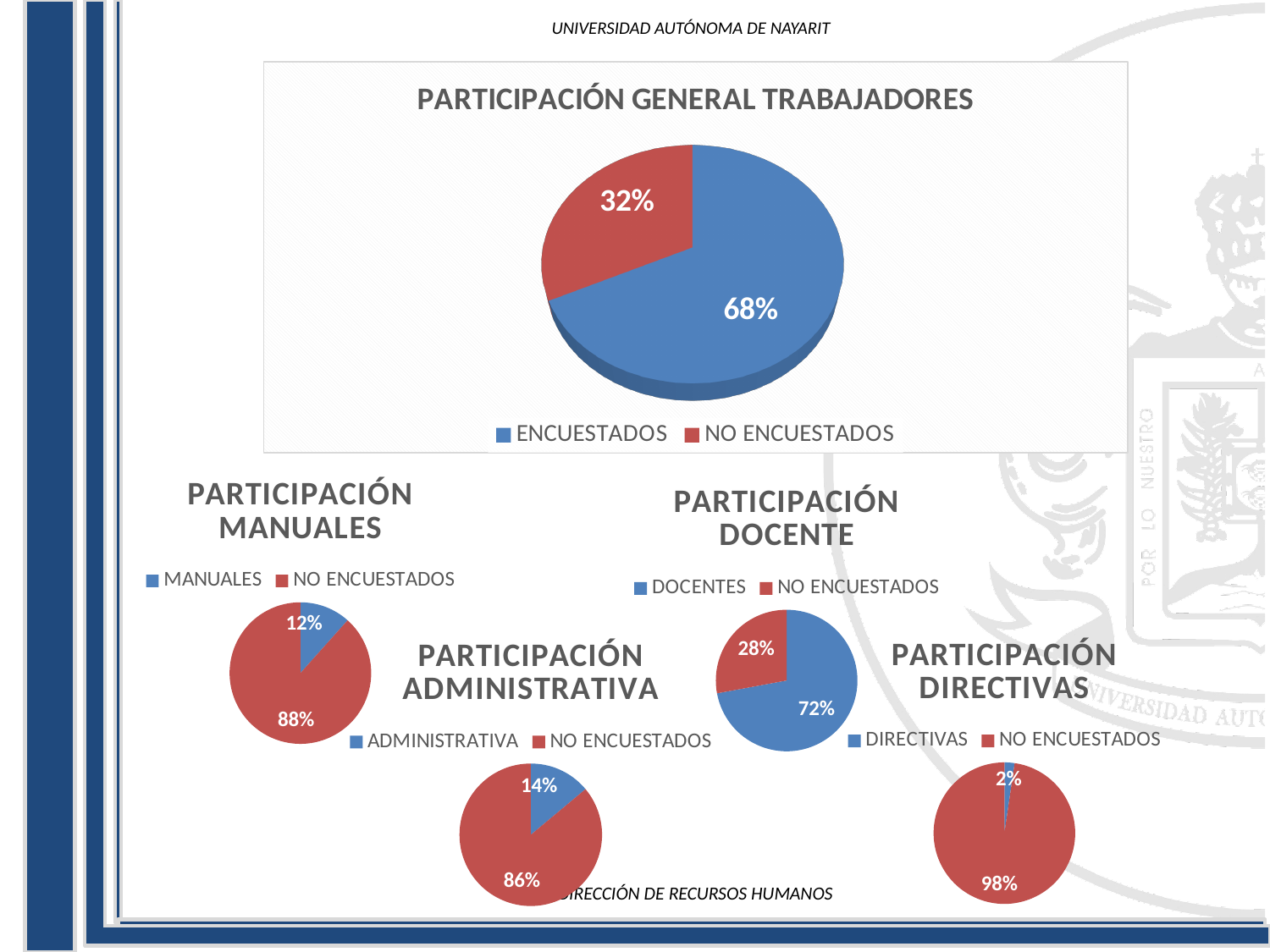
In the PARTICIPACIÓN GENERAL TRABAJADORES chart, what share of the pie is NO ENCUESTADOS? 32% In the PARTICIPACIÓN GENERAL TRABAJADORES chart, what share of the pie is ENCUESTADOS? 68% In the PARTICIPACIÓN DOCENTE chart, what share of the pie is DOCENTES? 72% In the PARTICIPACIÓN ADMINISTRATIVA chart, which slice is the smallest? ADMINISTRATIVA In the PARTICIPACIÓN MANUALES chart, which slice is larger, MANUALES or NO ENCUESTADOS? NO ENCUESTADOS In the PARTICIPACIÓN DOCENTE chart, what is the difference between the DOCENTES and NO ENCUESTADOS shares? 44% What kind of chart is the PARTICIPACIÓN GENERAL TRABAJADORES chart? Pie chart In the PARTICIPACIÓN DIRECTIVAS chart, which slice is the largest? NO ENCUESTADOS How many series does the legend of the PARTICIPACIÓN DOCENTE chart list? 2